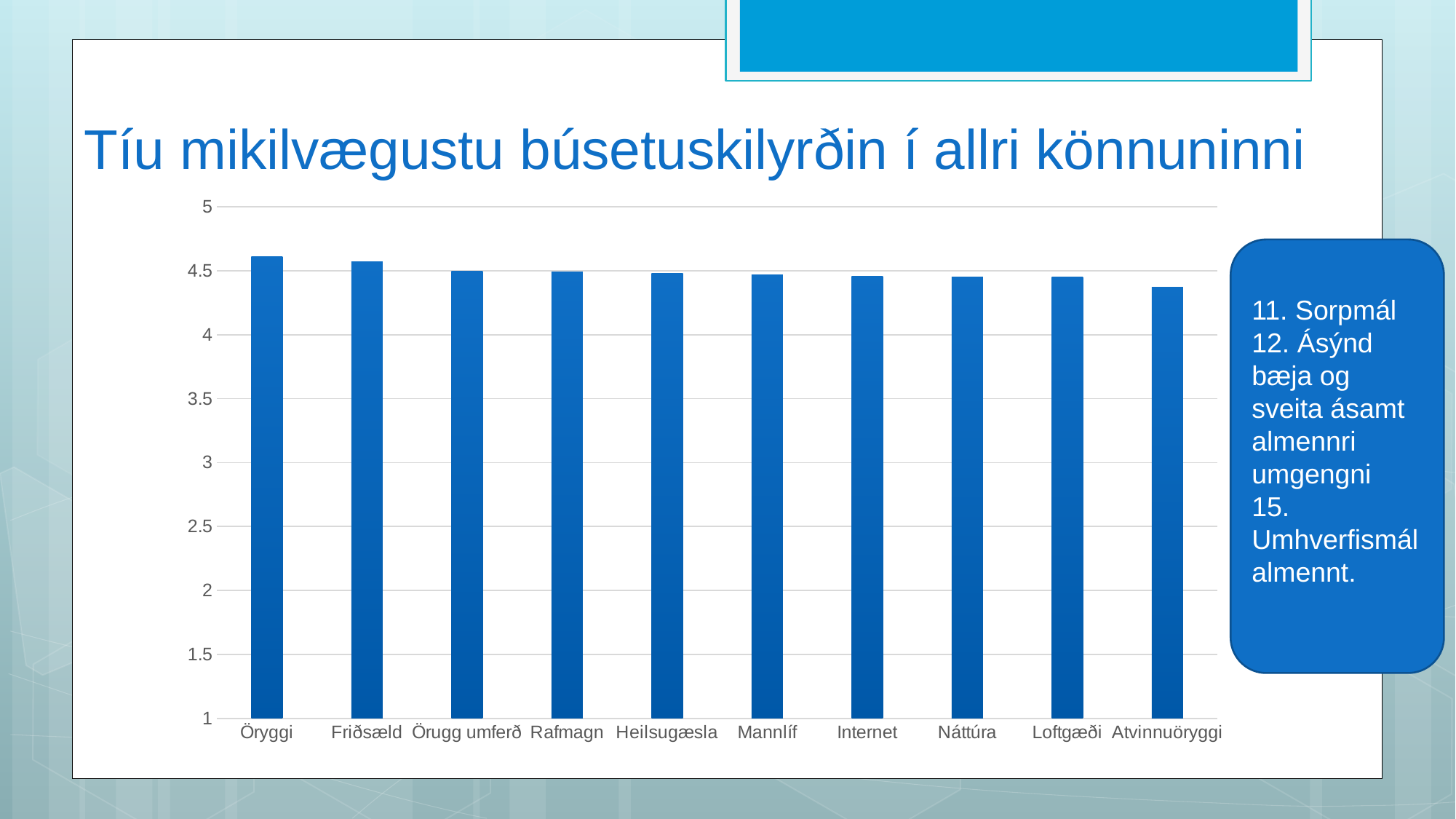
Do the bar values generally rise or fall from left to right along the x axis? Fall Is the value for Friðsæld greater or less than 4.5? greater How many categories are plotted on the chart? 10 Is the value for Öryggi greater or less than 4.5? greater Is the value for Internet greater or less than 4? greater What kind of chart is shown on the slide? Bar chart What is the title of the chart on the slide? Tíu mikilvægustu búsetuskilyrðin í allri könnuninni Which is larger, the value for Friðsæld or the value for Atvinnuöryggi? Friðsæld Which category has the lowest value on the chart? Atvinnuöryggi Which is larger, the value for Öryggi or the value for Atvinnuöryggi? Öryggi Which category has the highest value on the chart? Öryggi